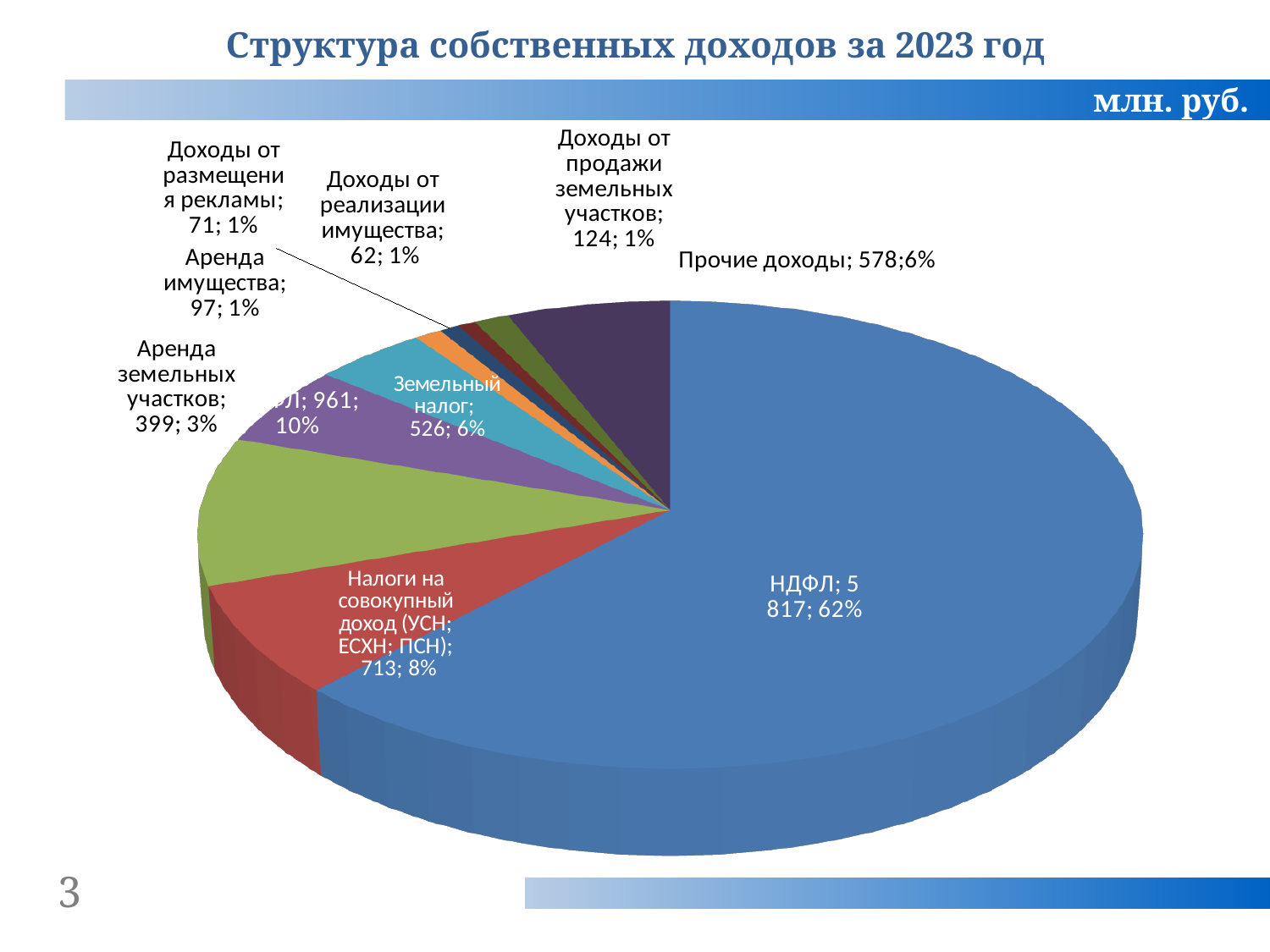
What unit of measurement is indicated on the slide for the chart values? млн. руб. What share of the pie does НДФЛ represent? 62% Which category has the smallest value? Доходы от реализации имущества What is the difference between the values for Аренда земельных участков and Аренда имущества? 302 What is the value for НДФЛ? 5 817 What is the value for Земельный налог? 526 What is the title of the chart? Структура собственных доходов за 2023 год Which is larger, the value for Доходы от продажи земельных участков or the value for Доходы от размещения рекламы? Доходы от продажи земельных участков Which category has the largest slice of the pie? НДФЛ What is the value for Прочие доходы? 578 What kind of chart is shown on the slide? pie chart What share of the pie does Налоги на совокупный доход (УСН; ЕСХН; ПСН) represent? 8%